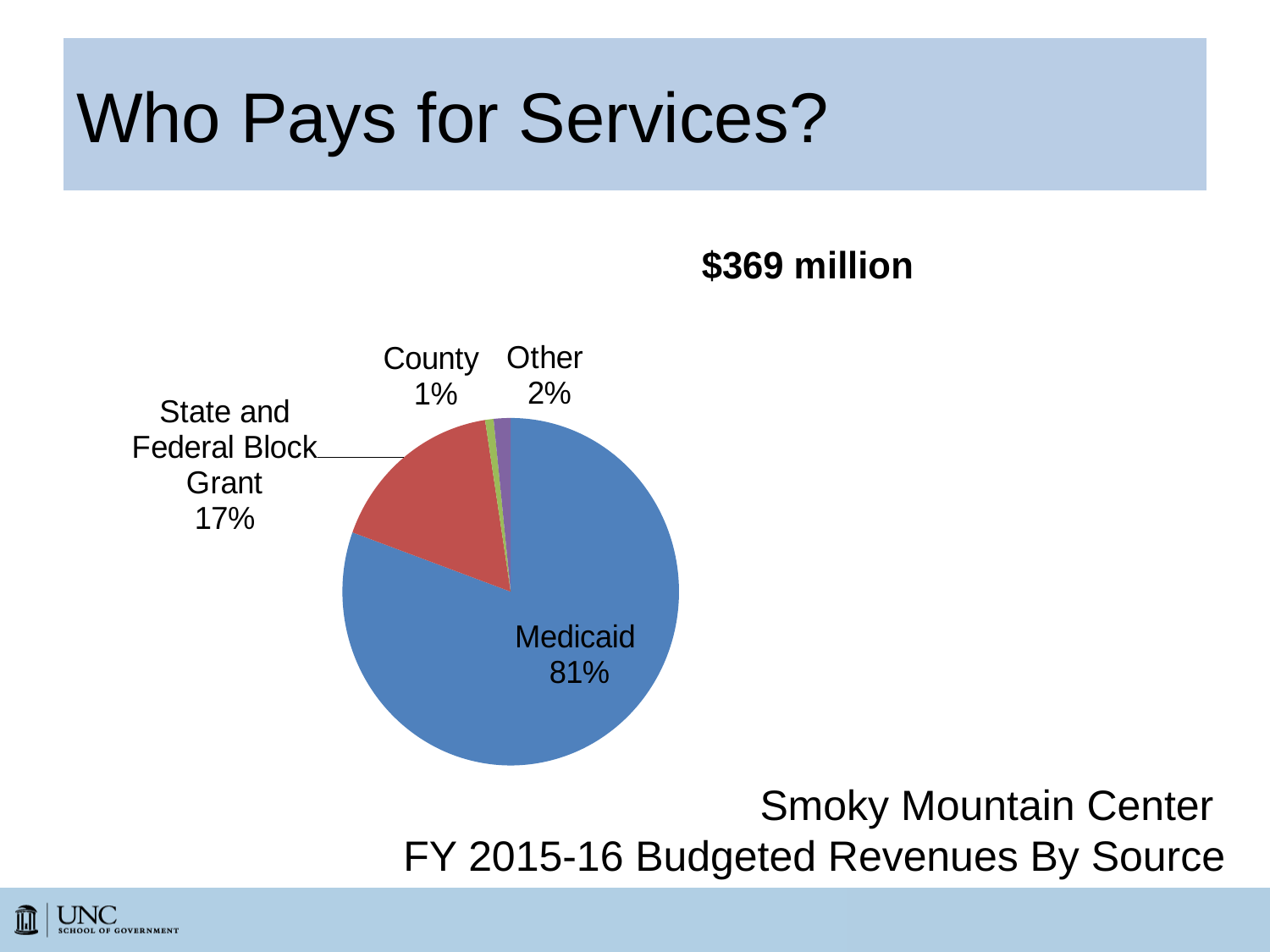
Which revenue source has the largest slice of the pie? Medicaid What colour is the Medicaid slice? Blue Which revenue source has the smallest slice of the pie? County What percentage is shown for Other? 2% What is the difference in percentage points between Medicaid and State and Federal Block Grant? 64 What share of the pie does Medicaid account for? 81% What kind of chart is shown on the slide? Pie chart Which is larger, the Other slice or the County slice? Other What total dollar amount is shown above the pie chart? $369 million What percentage is shown for County? 1% What percentage is shown for State and Federal Block Grant? 17% How many slices does the pie chart have? 4